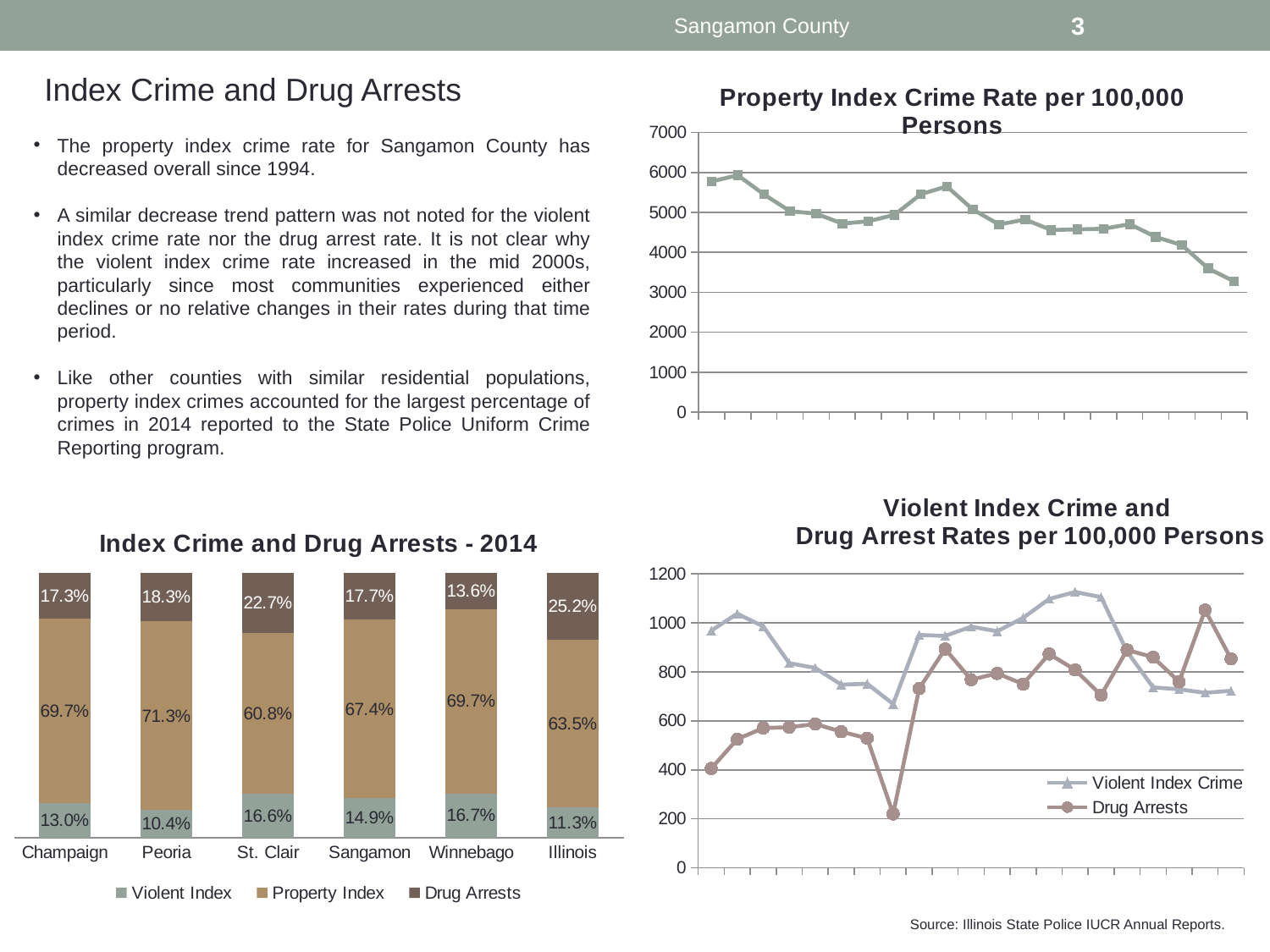
How many categories are shown on the x axis of the 'Index Crime and Drug Arrests - 2014' chart? 6 In the 'Index Crime and Drug Arrests - 2014' chart, which is larger: the Violent Index percentage for Winnebago or for Champaign? Winnebago In the 'Index Crime and Drug Arrests - 2014' chart, what is the difference between the Property Index percentages for Peoria and St. Clair? 10.5% What kind of chart is 'Property Index Crime Rate per 100,000 Persons'? Line chart In the 'Index Crime and Drug Arrests - 2014' chart, what is the Drug Arrests percentage for Illinois? 25.2% In the 'Index Crime and Drug Arrests - 2014' chart, which category has the lowest Violent Index percentage? Peoria In the 'Index Crime and Drug Arrests - 2014' chart, what is the Property Index percentage for Peoria? 71.3% In the 'Violent Index Crime and Drug Arrest Rates per 100,000 Persons' chart, is the lowest Drug Arrests value greater or less than 400? less In the 'Property Index Crime Rate per 100,000 Persons' chart, do the values generally rise or fall along the x axis? Fall In the 'Index Crime and Drug Arrests - 2014' chart, what is the Violent Index percentage for Sangamon? 14.9% How many series does the legend of the 'Index Crime and Drug Arrests - 2014' chart list? 3 In the 'Index Crime and Drug Arrests - 2014' chart, which category has the highest Drug Arrests percentage? Illinois